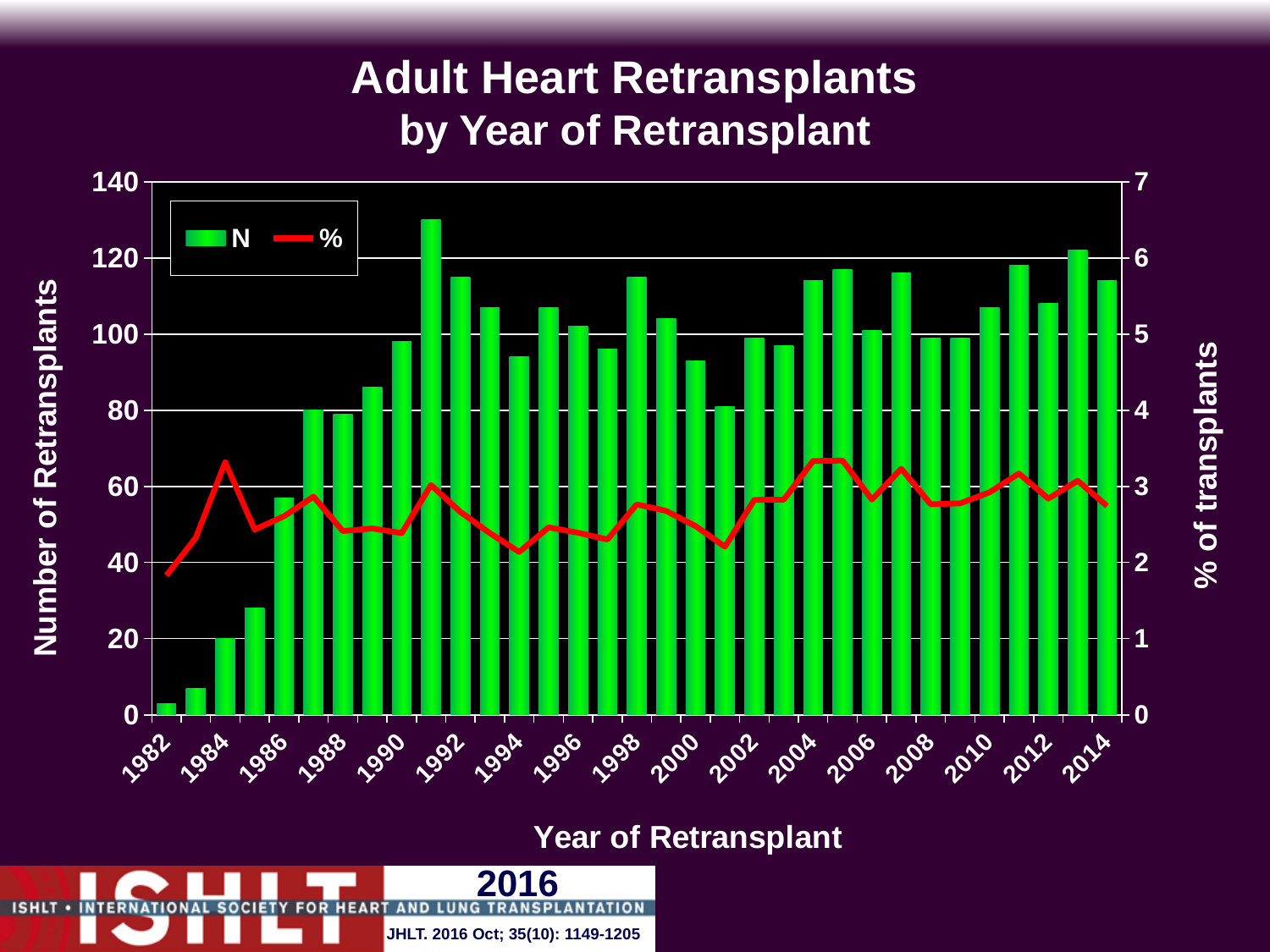
Is the % of transplants value for 1982 greater or less than 2? less What is the title of the chart? Adult Heart Retransplants by Year of Retransplant What kind of chart is used to show the N series? bar chart Which year has the lowest number of retransplants (shortest bar)? 1982 Which year has the highest number of retransplants (tallest bar)? 1991 How many series does the legend list? 2 Which year has more retransplants, 1991 or 1992? 1991 Is the number of retransplants for 1991 greater or less than 120? greater Do the number of retransplants rise or fall from 1982 to 1991? rise Is the number of retransplants for 1982 greater or less than 20? less